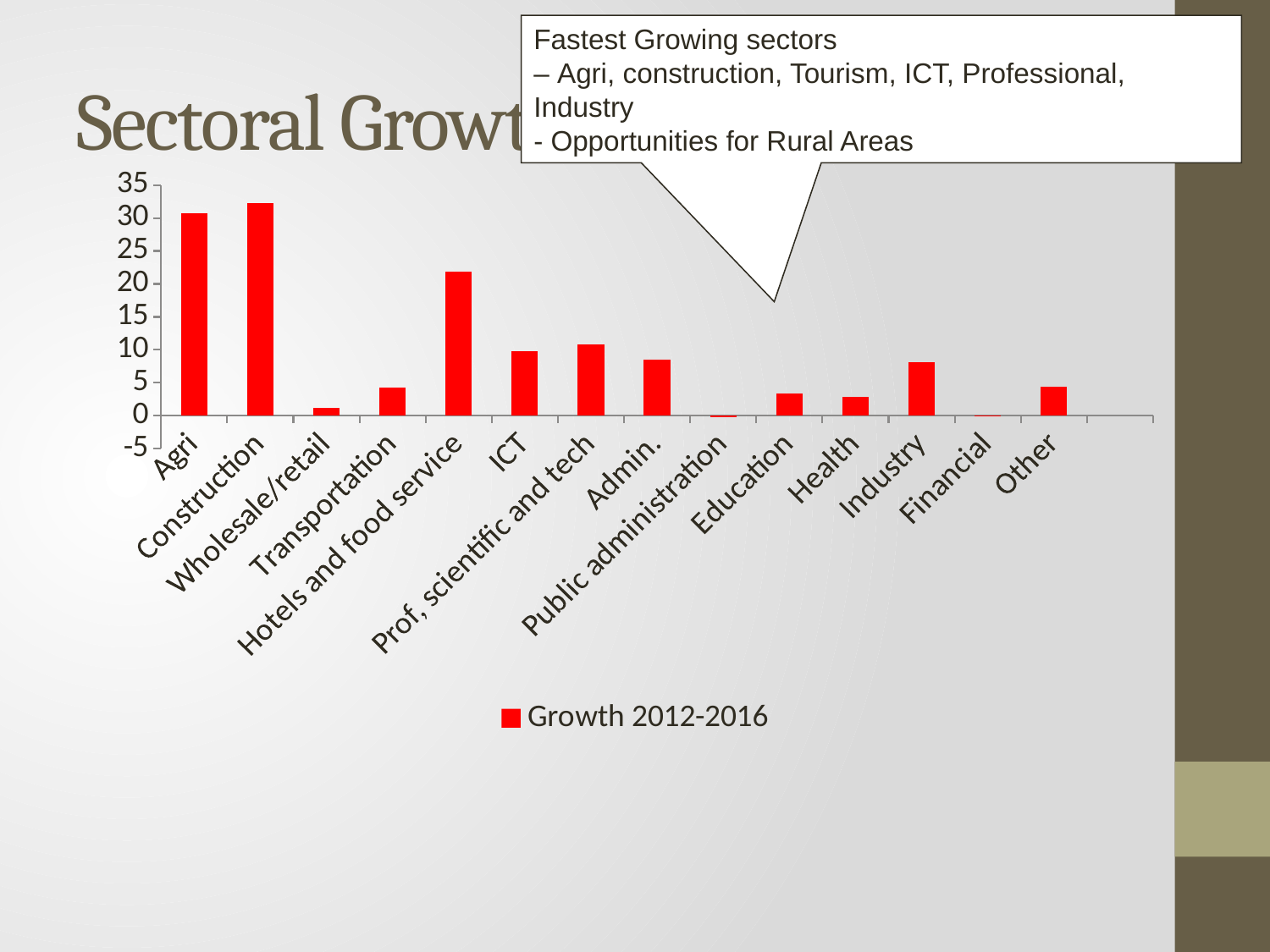
Which has the larger value, Hotels and food service or ICT? Hotels and food service Is the value for Education greater or less than 5? less Is the value for Agri greater or less than 25? greater What colour are the bars in the chart? red Is the value for Hotels and food service greater or less than 20? greater Which has the larger value, Industry or Health? Industry How many sectors (categories) are plotted on the x axis? 14 What kind of chart is shown on the slide? bar chart Which sector has the highest growth value? Construction How many series does the legend list? 1 What is the name of the series shown in the legend? Growth 2012-2016